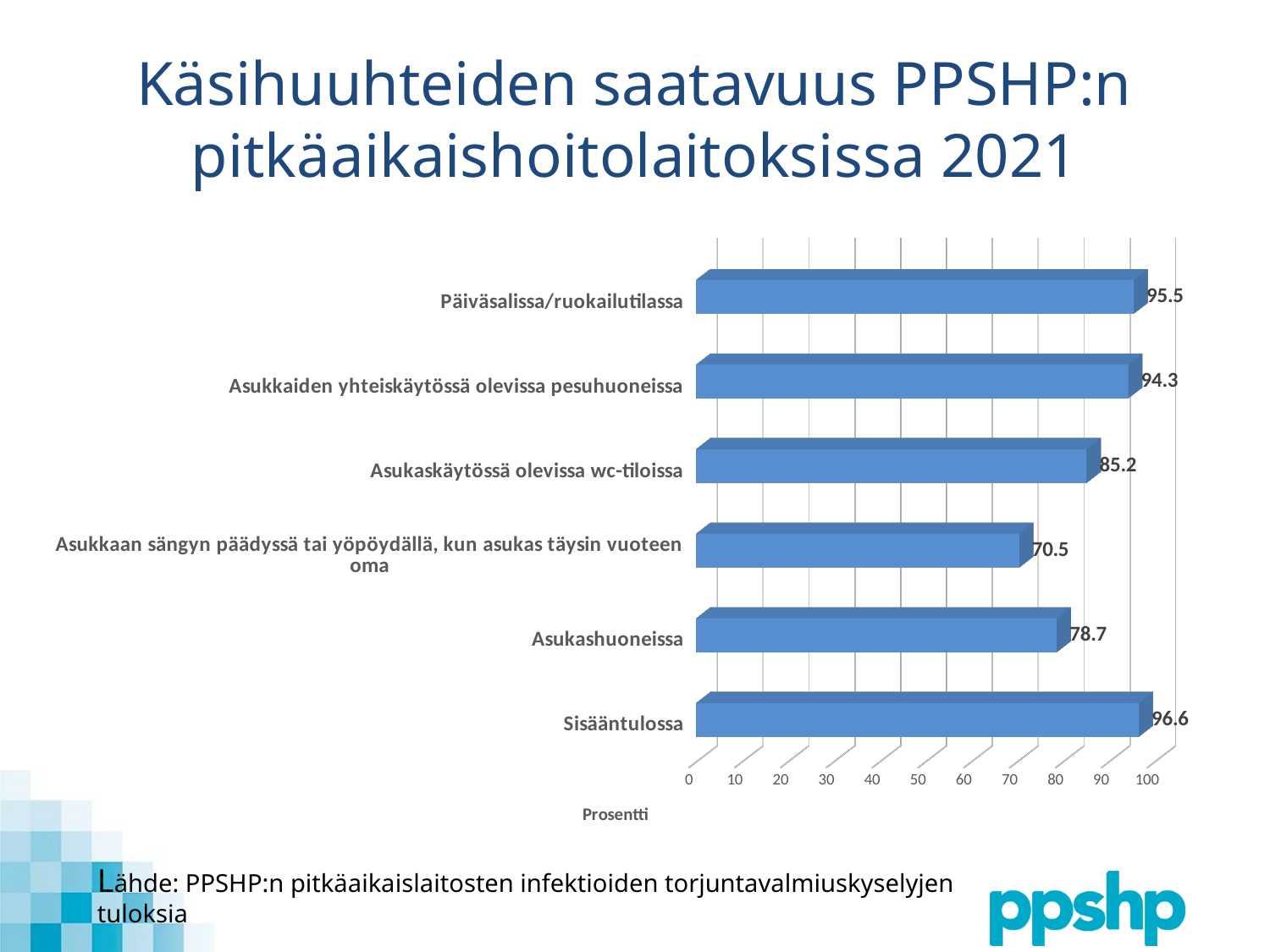
What is the label of the horizontal axis? Prosentti How many categories are shown in the chart? 6 What is the difference between the values for Sisääntulossa and Asukashuoneissa? 17.9 Is the value for Asukashuoneissa greater or less than 80? less What is the value for Päiväsalissa/ruokailutilassa? 95.5 What is the value for Asukaskäytössä olevissa wc-tiloissa? 85.2 What is the value for Sisääntulossa? 96.6 What is the value for Asukashuoneissa? 78.7 What kind of chart is shown on the slide? bar chart Which is larger, the value for Asukkaiden yhteiskäytössä olevissa pesuhuoneissa or the value for Asukaskäytössä olevissa wc-tiloissa? Asukkaiden yhteiskäytössä olevissa pesuhuoneissa Which category has the lowest value? Asukkaan sängyn päädyssä tai yöpöydällä, kun asukas täysin vuoteen oma Which category has the highest value? Sisääntulossa